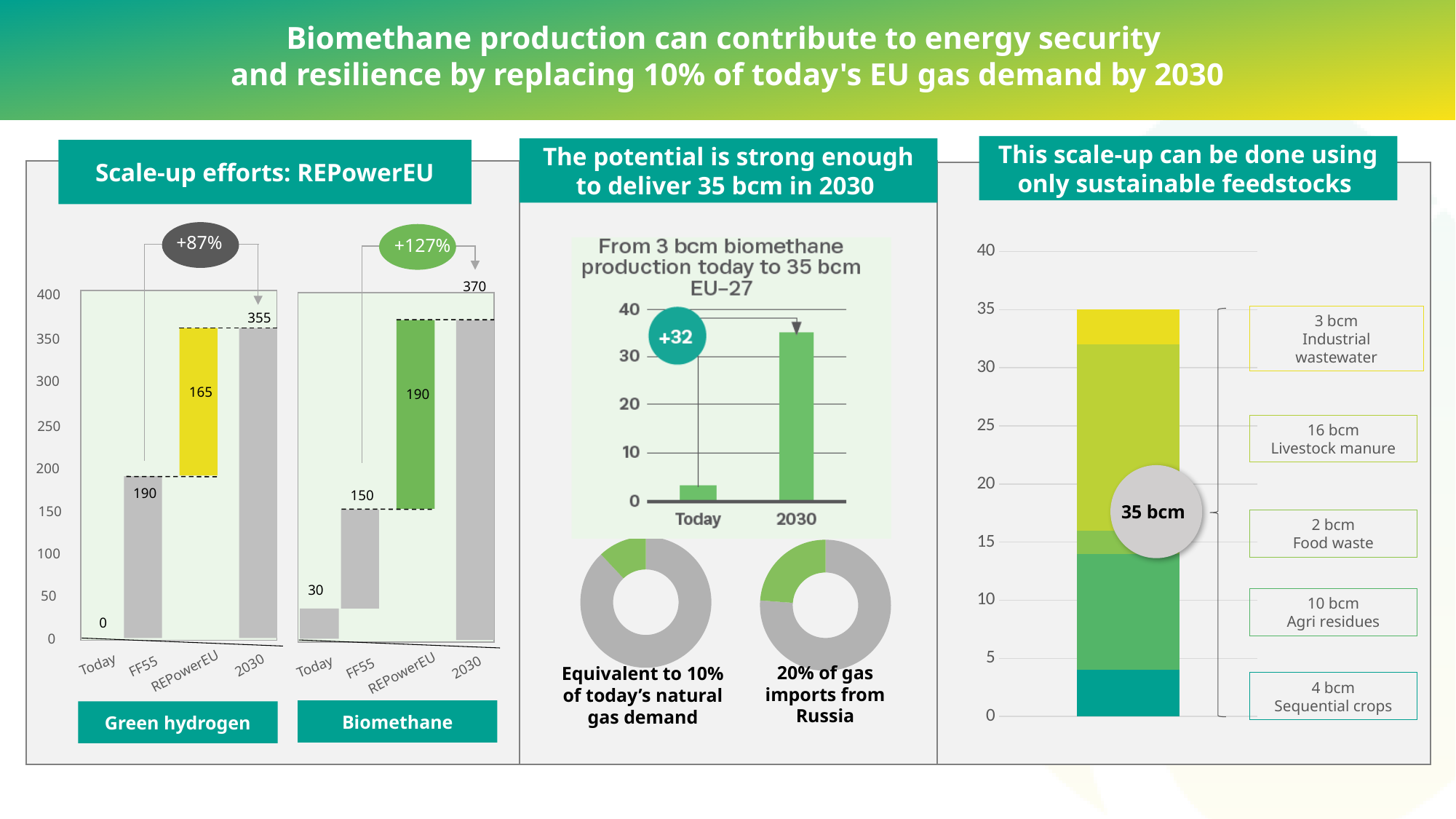
In the 'This scale-up can be done using only sustainable feedstocks' chart, how many bcm come from Livestock manure? 16 bcm In the 'Scale-up efforts: REPowerEU' panel, which has the larger 2030 value, Green hydrogen or Biomethane? Biomethane In the 'Scale-up efforts: REPowerEU' panel, what percentage increase is shown above the Biomethane chart? +127% In the 'This scale-up can be done using only sustainable feedstocks' chart, what is the total of the stacked bar? 35 bcm In the 'This scale-up can be done using only sustainable feedstocks' chart, which feedstock contributes the least? Food waste In the 'Scale-up efforts: REPowerEU' panel, what is the Today value for Biomethane? 30 In the 'Scale-up efforts: REPowerEU' panel, what is the FF55 value for Biomethane? 150 In the 'Scale-up efforts: REPowerEU' panel, what is the difference between the REPowerEU contribution for Biomethane (190) and for Green hydrogen (165)? 25 In the 'Scale-up efforts: REPowerEU' panel, what is the 2030 value for Biomethane? 370 In the middle panel bar chart 'From 3 bcm biomethane production today to 35 bcm EU-27', what increase is shown in the circle between Today and 2030? +32 In the 'Scale-up efforts: REPowerEU' panel, what is the 2030 value for Green hydrogen? 355 In the middle panel bar chart 'From 3 bcm biomethane production today to 35 bcm EU-27', is the 2030 bar greater or less than 30? greater